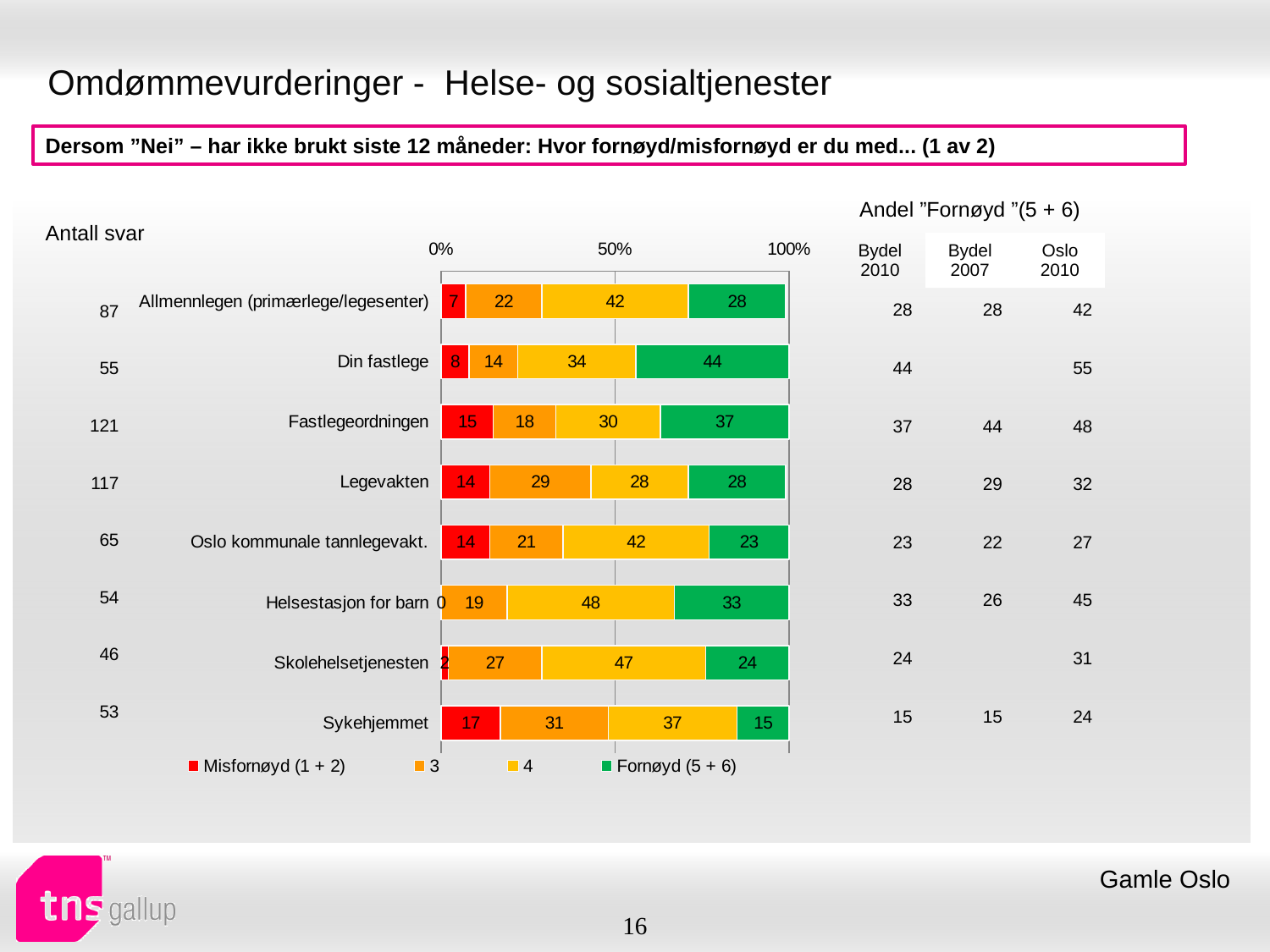
How many categories are shown in the bar chart? 8 What percentage of respondents were 'Fornøyd (5 + 6)' with Din fastlege? 44 What is the value of the '4' segment for Helsestasjon for barn? 48 What kind of chart is shown on the slide? Stacked bar chart Which category has the highest 'Fornøyd (5 + 6)' value? Din fastlege Which has a larger '3' segment, Legevakten or Fastlegeordningen? Legevakten How many series does the legend list? 4 What is the difference between the 'Fornøyd (5 + 6)' values for Din fastlege and Sykehjemmet? 29 What is the total of the stacked bar for Din fastlege? 100 Which category has the lowest 'Fornøyd (5 + 6)' value? Sykehjemmet What is the 'Misfornøyd (1 + 2)' value for Sykehjemmet? 17 Which category has the highest 'Misfornøyd (1 + 2)' value? Sykehjemmet